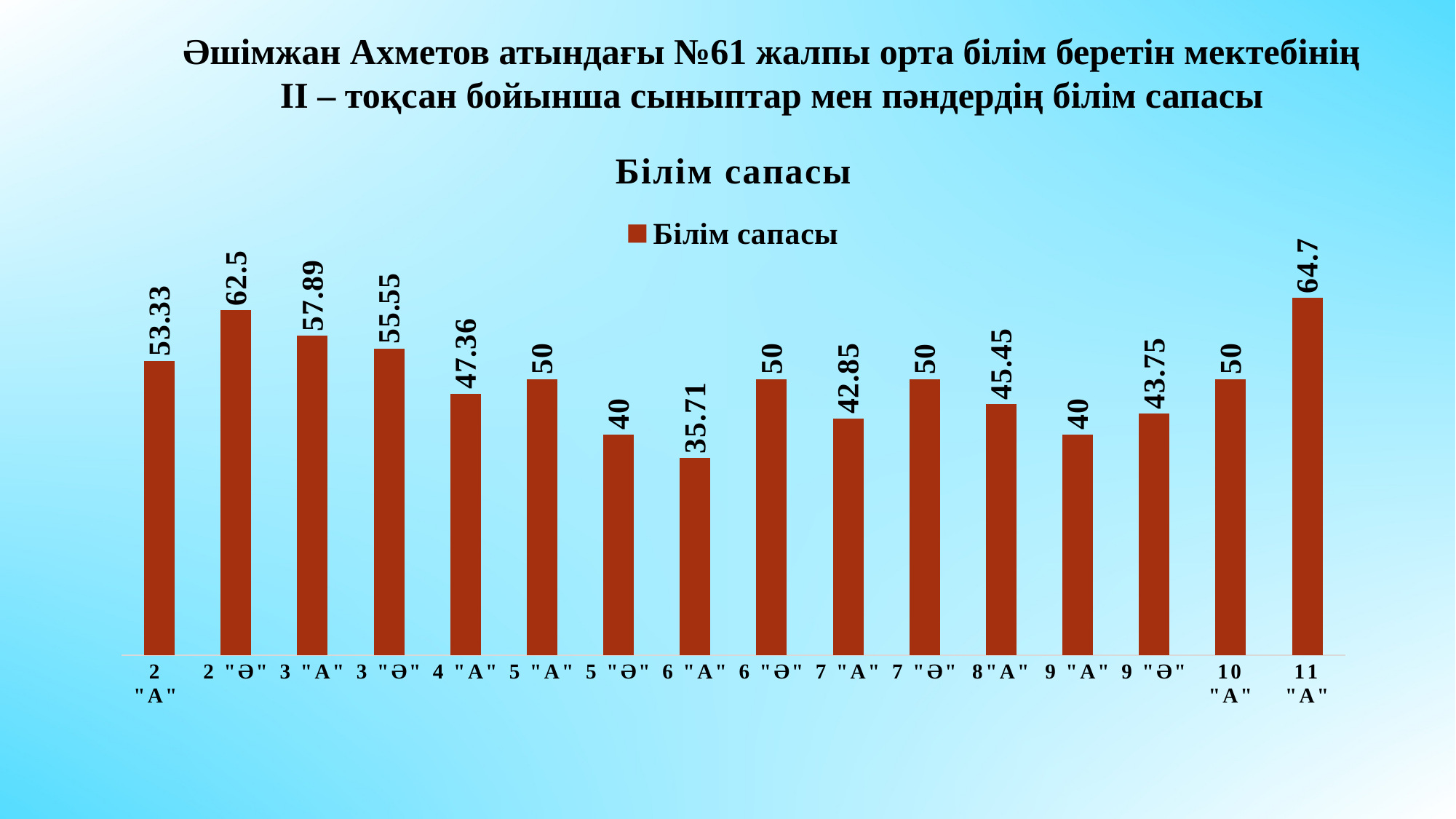
What is the difference between the values for 11 "А" and 6 "А"? 28.99 What is the value for 4 "А"? 47.36 What is the value for 2 "Ә"? 62.5 What is the difference between the values for 2 "Ә" and 2 "А"? 9.17 Which is larger, the value for 3 "А" or the value for 3 "Ә"? 3 "А" How many categories are shown on the x axis? 16 What is the value for 6 "А"? 35.71 Which category has the lowest value? 6 "А" What is the title of the chart? Білім сапасы Which category has the highest value? 11 "А" What kind of chart is this? Bar chart What is the value for 9 "Ә"? 43.75